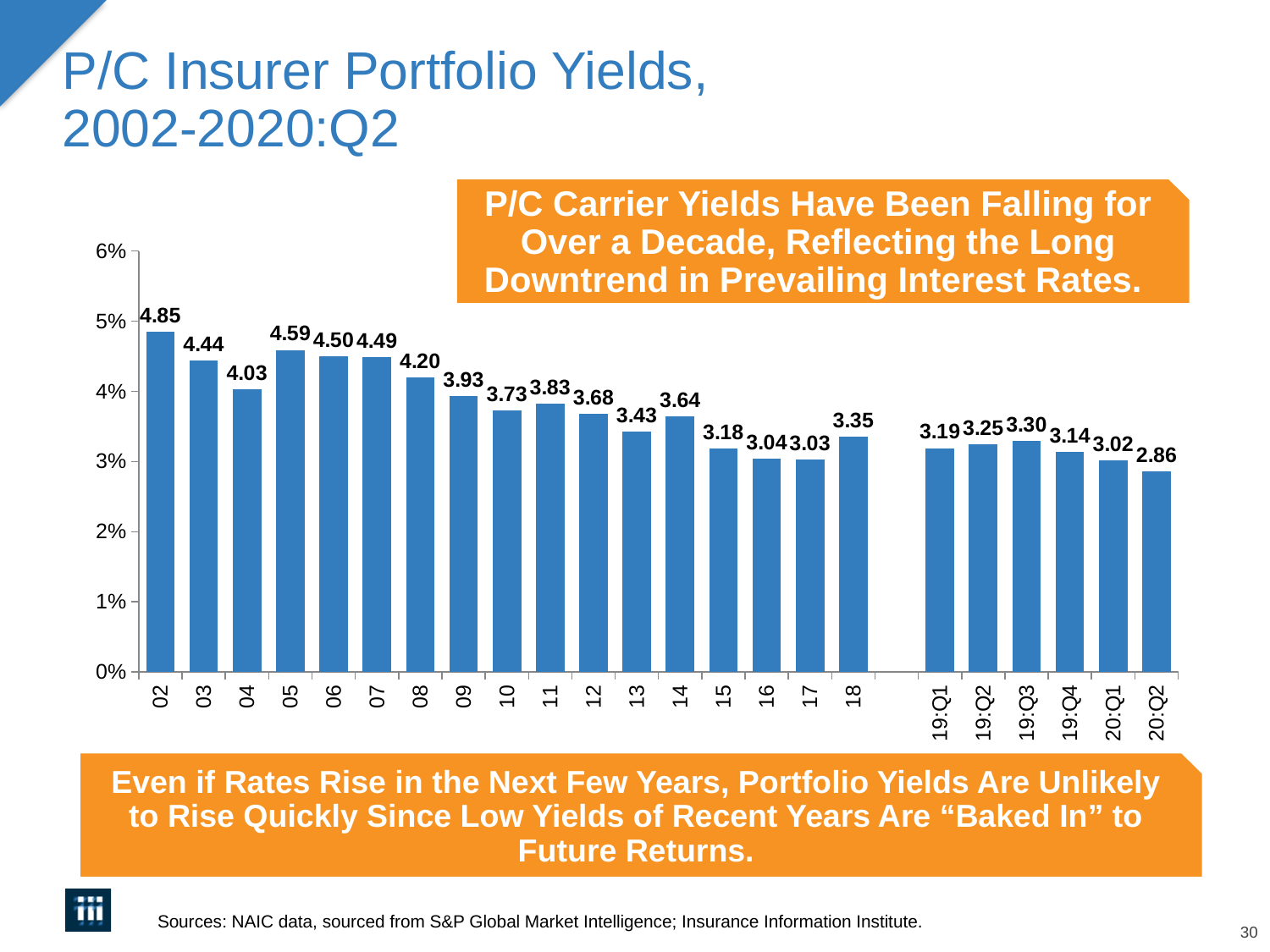
What is the portfolio yield shown for 2018 (label "18")? 3.35 Is the value for 08 greater or less than 4%? greater What is the title of the slide containing the chart? P/C Insurer Portfolio Yields, 2002-2020:Q2 Which period has the lowest portfolio yield on the chart? 20:Q2 What is the portfolio yield shown for 20:Q2? 2.86 Which is larger, the yield for 05 or the yield for 06? 05 What kind of chart is shown on the slide? bar chart Which period has the highest portfolio yield on the chart? 02 Do the portfolio yields generally rise or fall from 02 to 20:Q2? fall What is the difference between the yield for 02 and the yield for 20:Q2? 1.99 How many bars are plotted on the chart? 23 What is the P/C insurer portfolio yield shown for 2013 (label "13")? 3.43